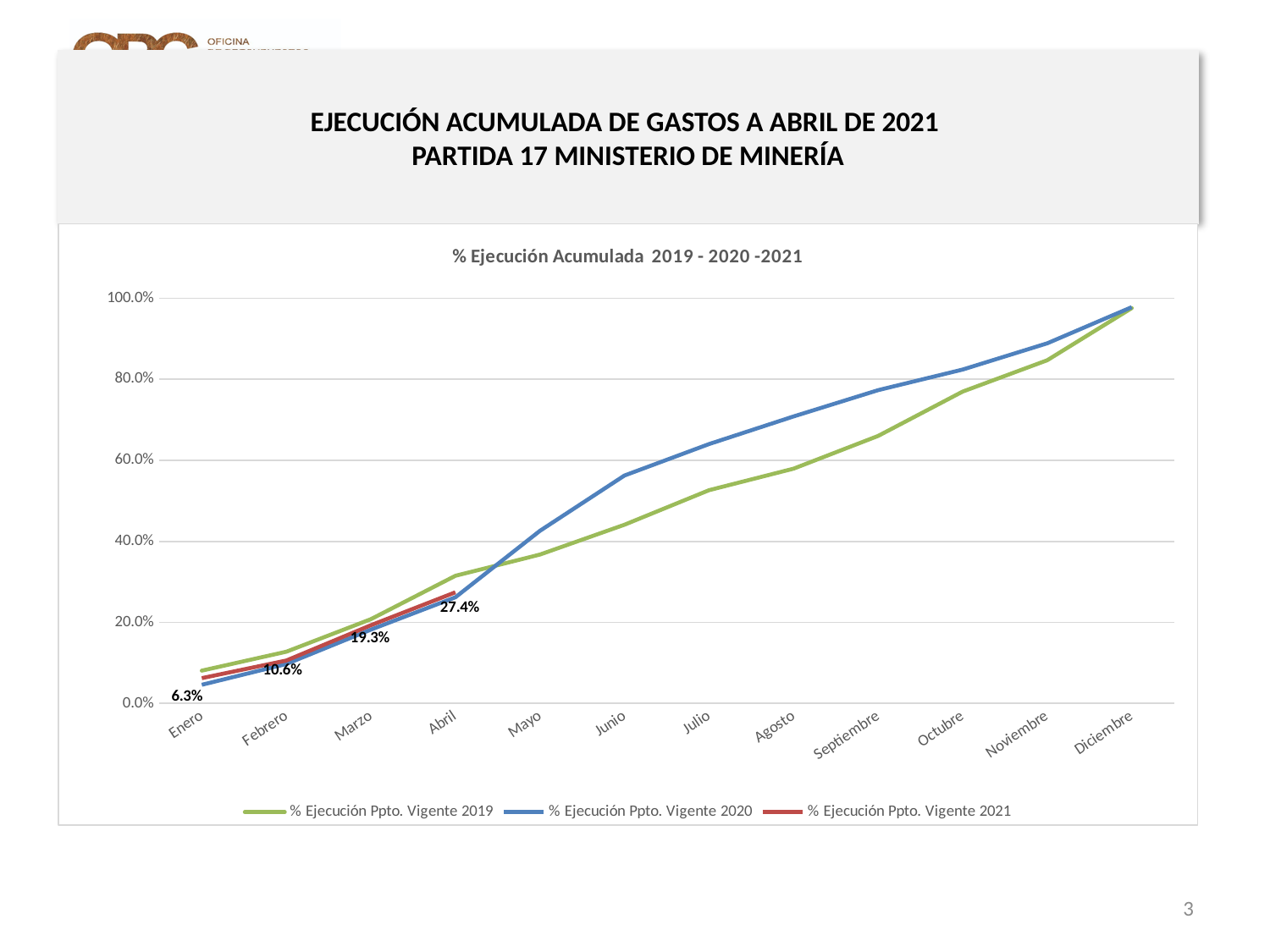
How many series does the legend list? 3 How many months are shown on the x axis? 12 What is the difference between the 2021 values for Febrero and Enero? 4.3 percentage points What is the value for % Ejecución Ppto. Vigente 2021 in Marzo? 19.3% What is the value for % Ejecución Ppto. Vigente 2021 in Abril? 27.4% Does the % Ejecución Ppto. Vigente 2020 series rise or fall from Enero to Diciembre? Rise What kind of chart is shown on the slide? Line chart In Junio, which series has the larger value, 2019 or 2020? 2020 Among the labelled months for the 2021 series, which month has the highest value? Abril Is the value for % Ejecución Ppto. Vigente 2020 in Junio greater or less than 40.0%? greater What is the value for % Ejecución Ppto. Vigente 2021 in Enero? 6.3% What is the difference between the 2021 values for Abril and Marzo? 8.1 percentage points